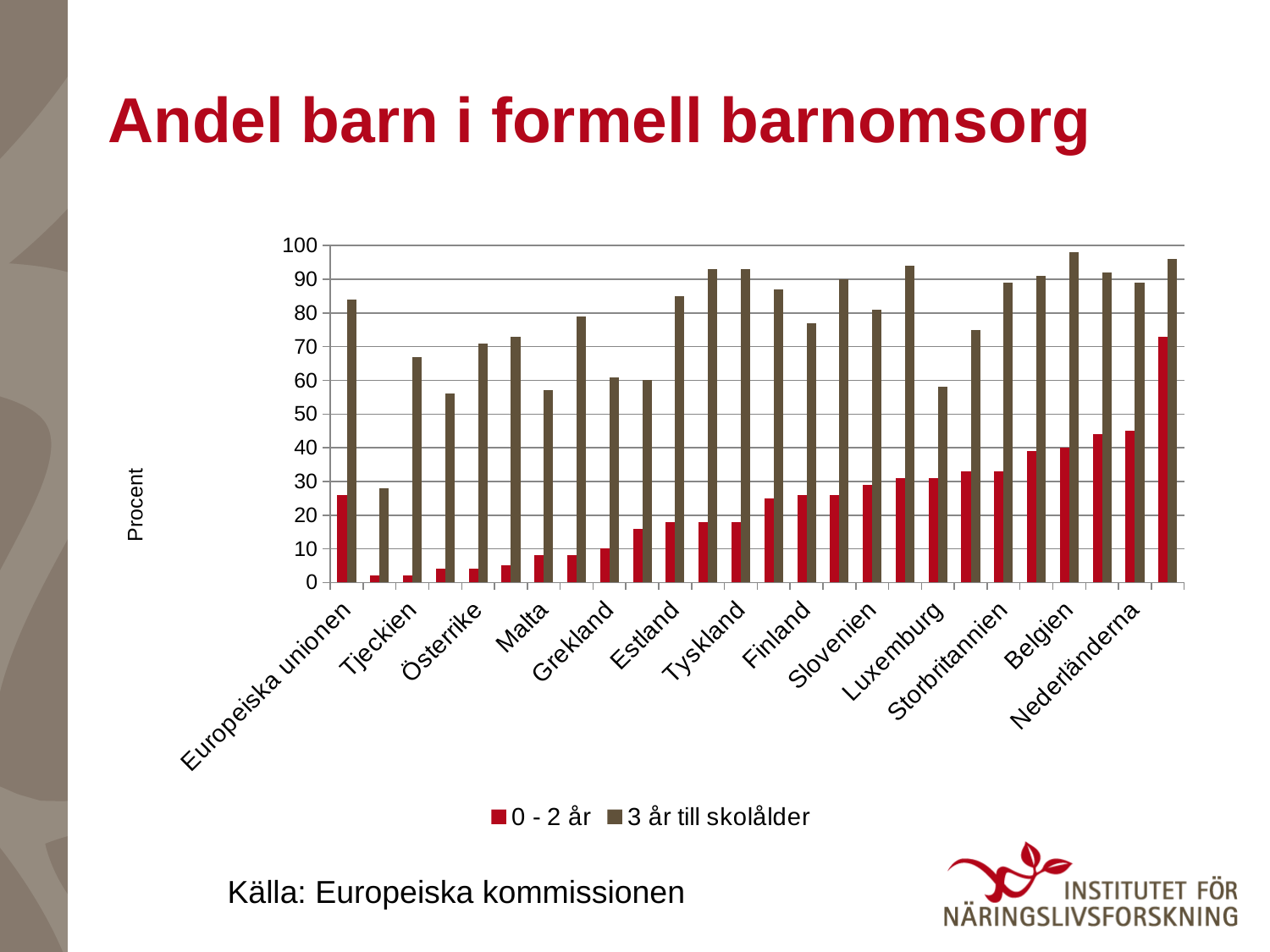
Is the 3 år till skolålder value for Belgien greater or less than 90? greater Do the values for the 0 - 2 år series generally rise or fall from left to right along the x axis? rise Is the 3 år till skolålder value for Tyskland greater or less than 80? greater What is the label on the vertical axis? Procent Is the 0 - 2 år value for Tjeckien greater or less than 10? less How many series does the legend list? 2 What are the two series named in the legend? 0 - 2 år and 3 år till skolålder What kind of chart is shown on the slide? bar chart For Europeiska unionen, which series has the larger value, 0 - 2 år or 3 år till skolålder? 3 år till skolålder